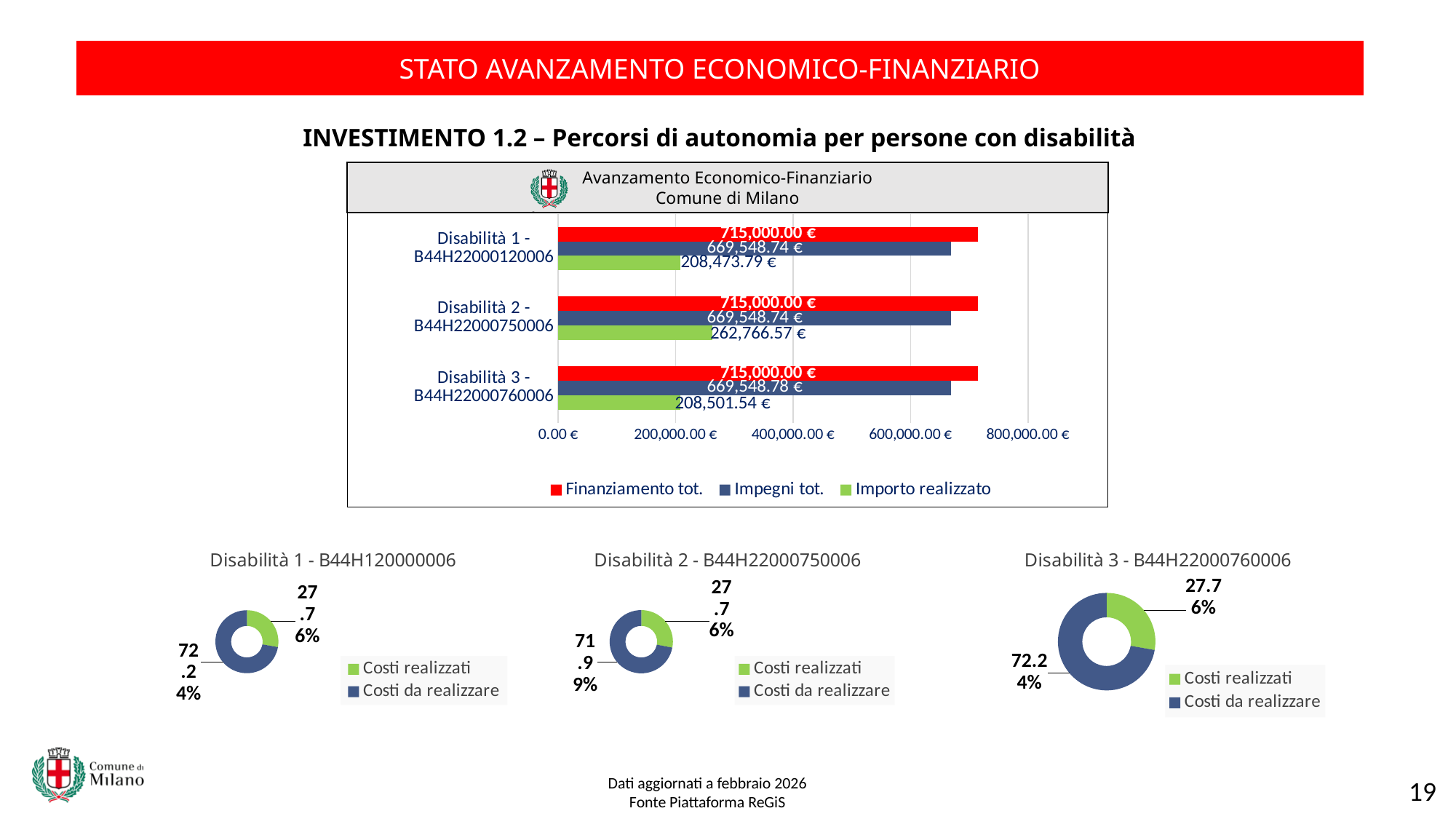
How many categories are shown in the bar chart 'Avanzamento Economico-Finanziario Comune di Milano'? 3 In the chart 'Disabilità 3 - B44H22000760006' at the bottom right, what share is Costi realizzati? 27.76% In the bar chart 'Avanzamento Economico-Finanziario Comune di Milano', what is the Importo realizzato for Disabilità 2 - B44H22000750006? 262,766.57 € In the bar chart 'Avanzamento Economico-Finanziario Comune di Milano', what is the Finanziamento tot. value for Disabilità 1 - B44H22000120006? 715,000.00 € How many series does the legend of the bar chart 'Avanzamento Economico-Finanziario Comune di Milano' list? 3 In the bar chart 'Avanzamento Economico-Finanziario Comune di Milano', what is the difference between Finanziamento tot. and Impegni tot. for Disabilità 1 - B44H22000120006? 45,451.26 € In the bar chart 'Avanzamento Economico-Finanziario Comune di Milano', what is the Impegni tot. value for Disabilità 3 - B44H22000760006? 669,548.78 € In the bar chart 'Avanzamento Economico-Finanziario Comune di Milano', is the Importo realizzato for Disabilità 3 - B44H22000760006 greater or less than 400,000.00 €? less In the bar chart 'Avanzamento Economico-Finanziario Comune di Milano', how much larger is the Importo realizzato for Disabilità 2 than for Disabilità 1? 54,292.78 € What kind of chart is the 'Avanzamento Economico-Finanziario Comune di Milano' chart? Bar chart In the bar chart 'Avanzamento Economico-Finanziario Comune di Milano', which category has the highest Importo realizzato? Disabilità 2 - B44H22000750006 In the chart 'Disabilità 3 - B44H22000760006' at the bottom right, what share is Costi da realizzare? 72.24%